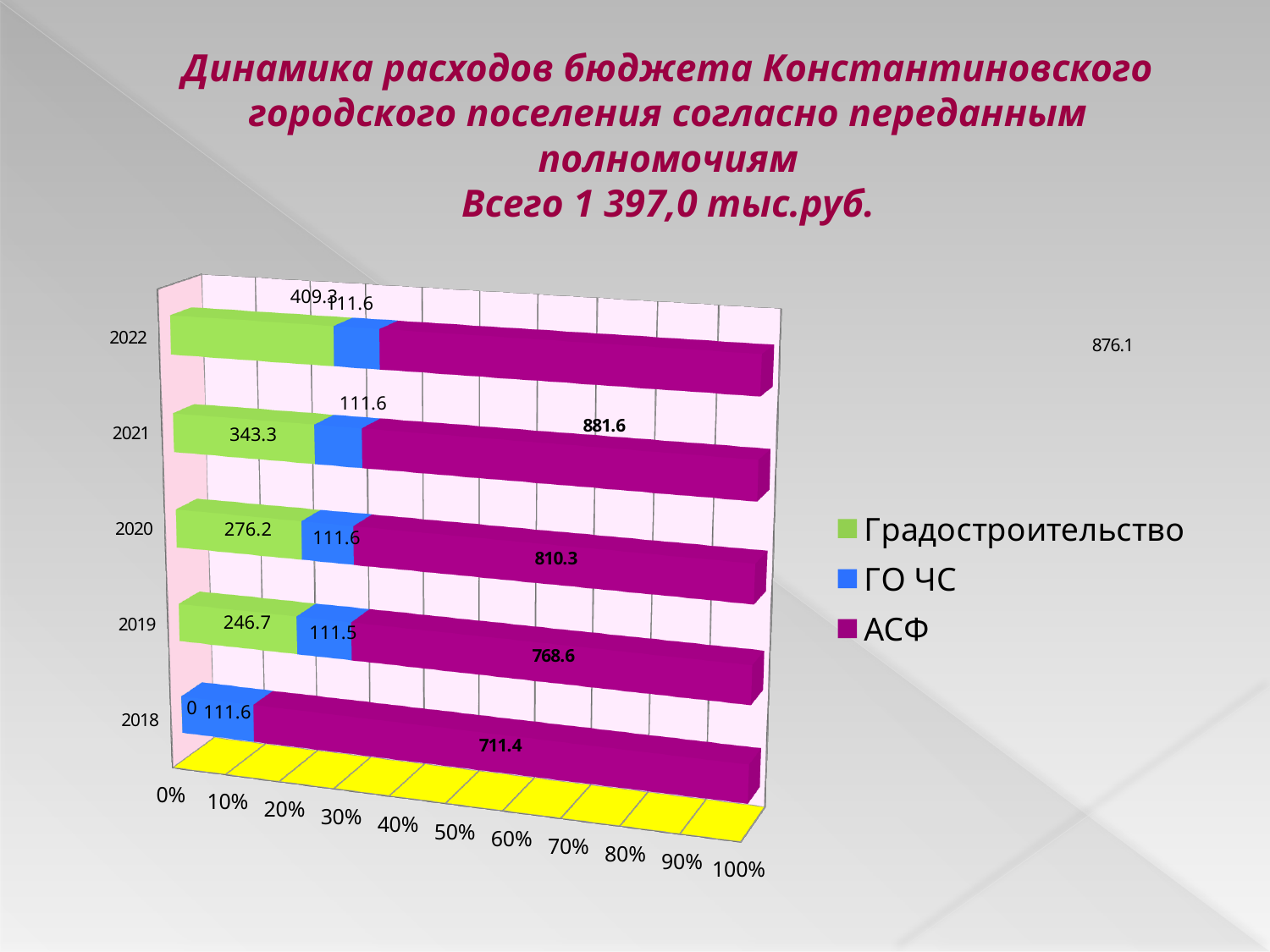
What is the value of Градостроительство for 2022? 409.3 Which is larger, the АСФ value for 2019 or for 2020? 2020 What is the value of АСФ for 2020? 810.3 In which year is the АСФ value lowest? 2018 What is the difference between the Градостроительство values for 2022 and 2021? 66.0 What is the value of ГО ЧС for 2019? 111.5 How many series does the legend list? 3 In which year is the АСФ value highest? 2021 How many years are shown on the chart? 5 Does the Градостроительство value rise or fall from 2018 to 2022? Rise What type of chart is shown on the slide? Stacked bar chart What is the value of Градостроительство for 2018? 0